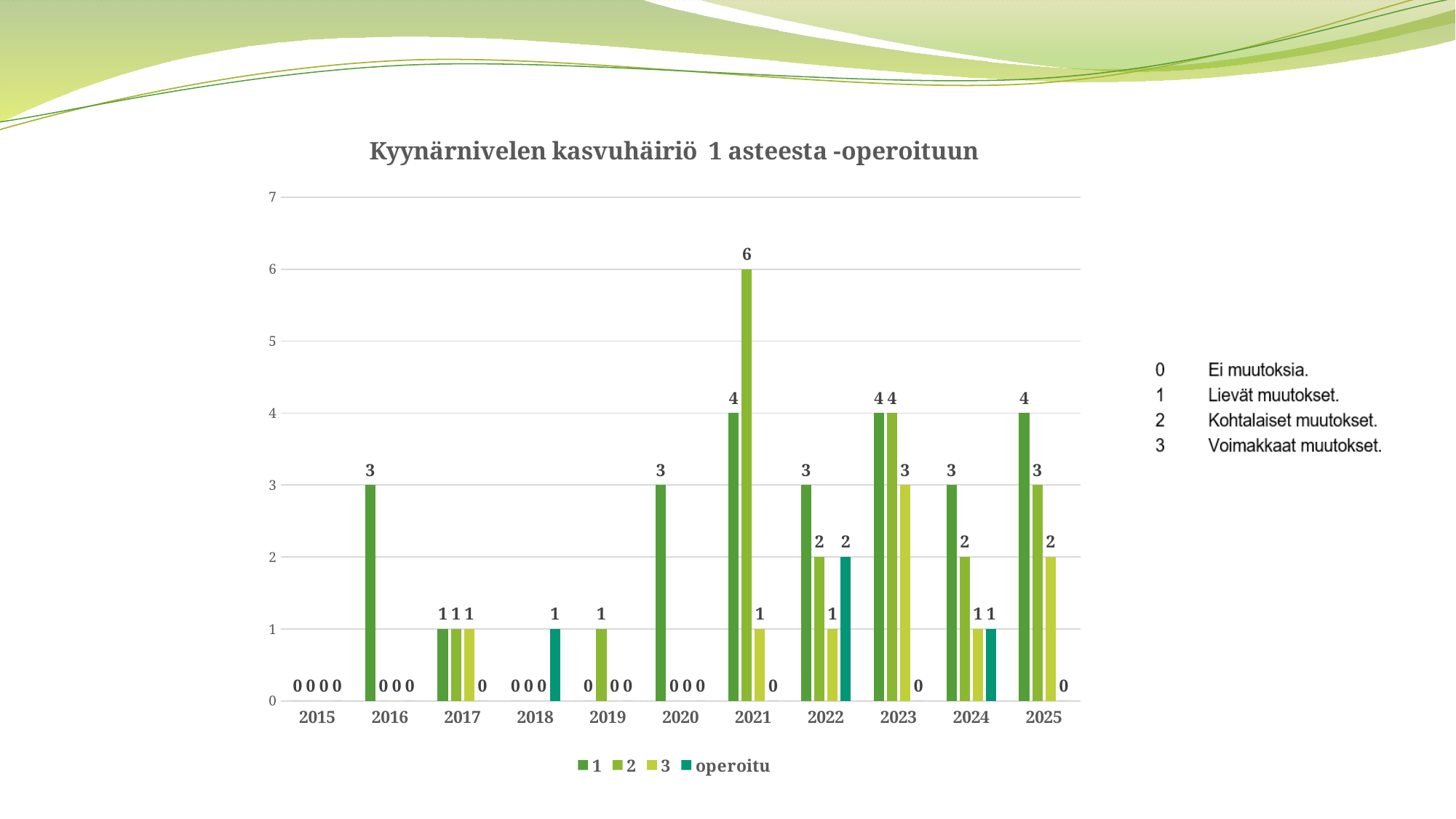
Which year has the highest value for series 2? 2021 What is the value for the operoitu series in 2022? 2 What is the value for series 2 in 2021? 6 Which is larger in 2025: series 1 or series 3? series 1 What is the title of the chart? Kyynärnivelen kasvuhäiriö 1 asteesta -operoituun What is the value for series 1 in 2015? 0 What is the difference between series 2 and series 1 in 2021? 2 What is the value for series 1 in 2016? 3 How many years are shown on the x axis? 11 What is the value for series 3 in 2023? 3 How many series does the legend list? 4 What kind of chart is shown on the slide? bar chart